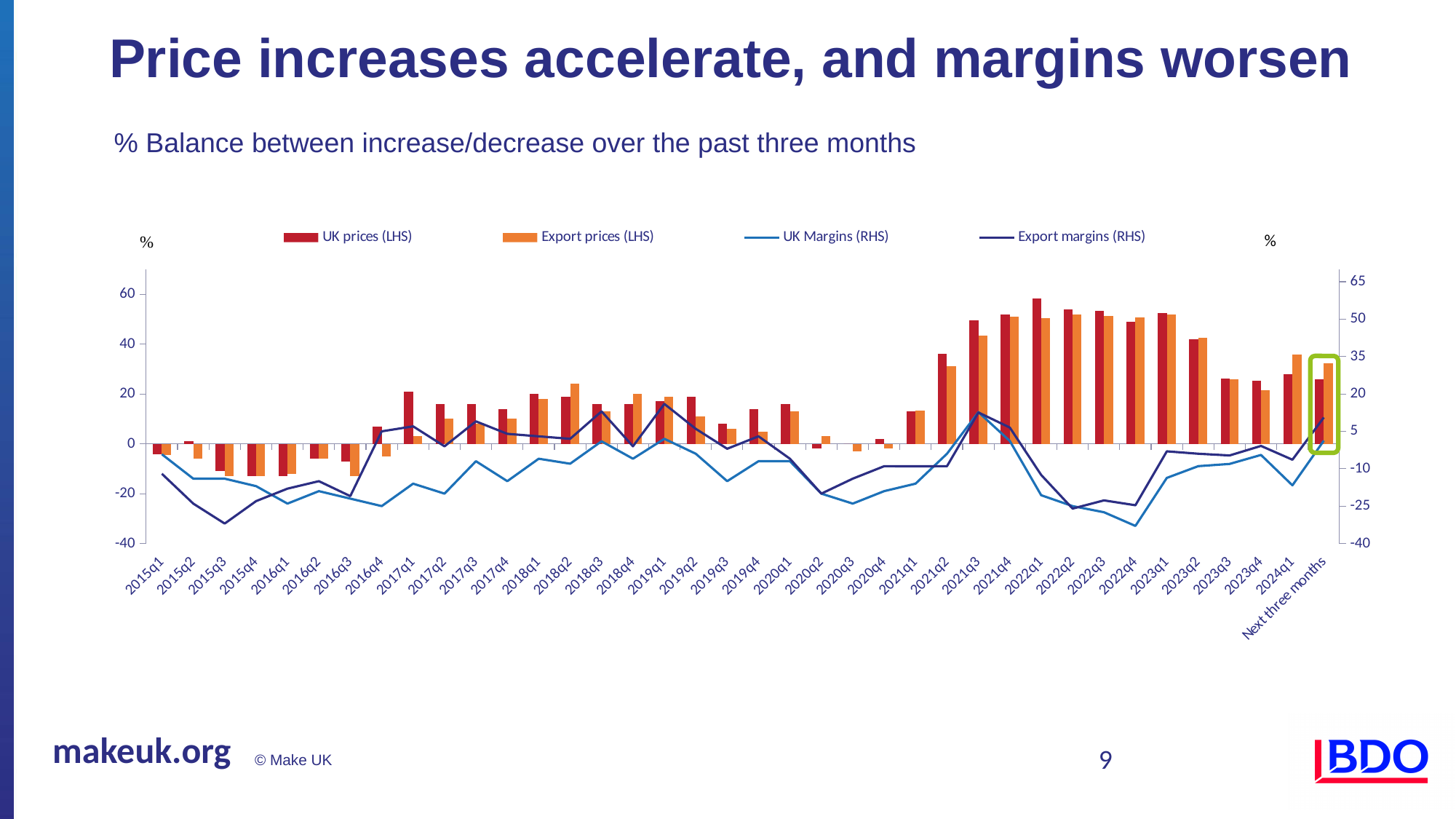
Is the Export prices value for 2021q3 greater or less than 40? greater Which is larger, the UK prices bar for 2017q1 or for 2016q4? 2017q1 Is the UK prices value for 2021q2 greater or less than 40? less Do the UK prices bars rise or fall from 2022q1 to 2023q3? fall Which is larger, the UK prices bar for 2022q1 or for 2023q3? 2022q1 Which series is plotted with the orange bars? Export prices (LHS) Is the UK Margins value for 2022q4 greater or less than -25 on the right-hand axis? less How many categories are shown along the x axis? 38 How many series does the legend list? 4 What kind of chart is shown on the slide? A combined bar and line chart In which period is the UK prices bar highest? 2022q1